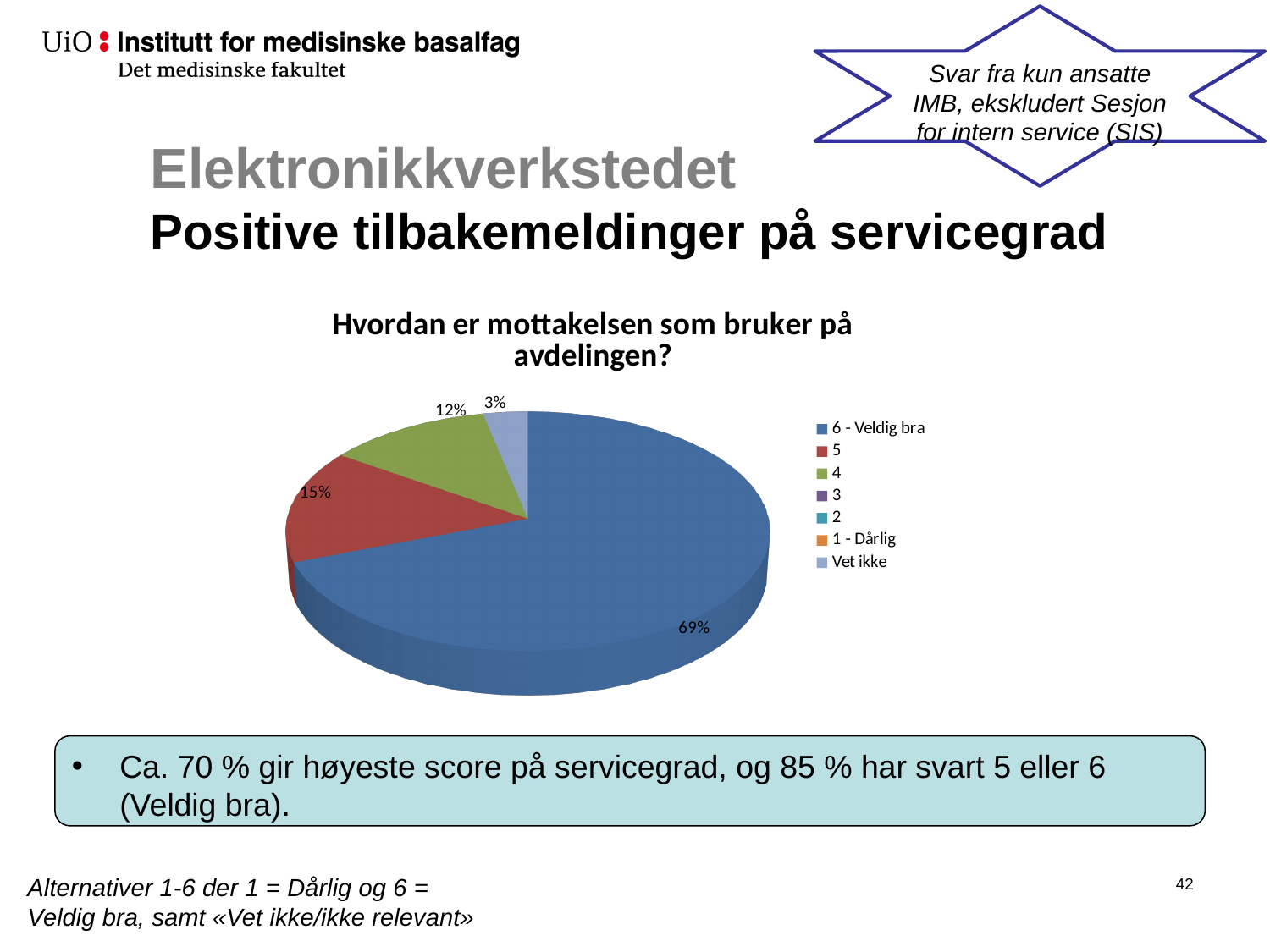
Which category has the largest slice of the pie? 6 - Veldig bra What is the combined share of the "6 - Veldig bra" and "5" slices? 84% What share of the pie is labelled for "6 - Veldig bra"? 69% Which slice is larger, "5" or "4"? 5 How many entries does the chart legend list? 7 What share of the pie is labelled for "4"? 12% What kind of chart is shown on the slide? pie chart What share of the pie is labelled for "5"? 15% Which of the labelled slices is the smallest? Vet ikke What is the difference in percentage points between the "6 - Veldig bra" slice and the "5" slice? 54 What is the title of the chart? Hvordan er mottakelsen som bruker på avdelingen?